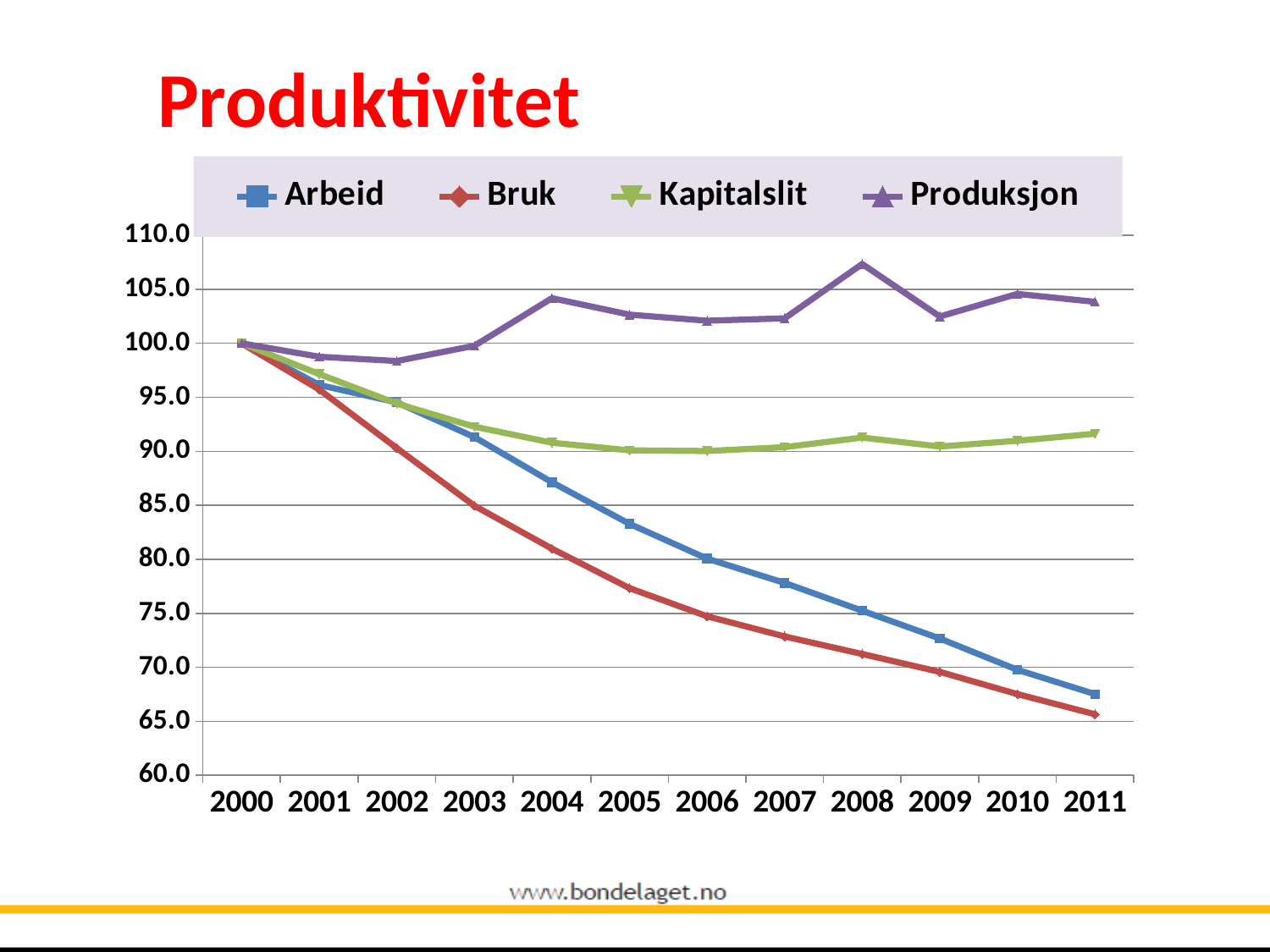
Which series has the highest value in 2011? Produksjon What kind of chart is shown on the slide? line chart Which series has the lowest value in 2011? Bruk Is the value for Kapitalslit in 2005 greater or less than 95.0? less Is the value for Bruk in 2011 greater or less than 70.0? less Does the Bruk series rise or fall from 2000 to 2011? fall Is the value for Produksjon in 2008 greater or less than 105.0? greater How many years are shown on the x axis? 12 What is the value of Arbeid in 2000? 100.0 How many series does the legend list? 4 In 2011, which is larger, Arbeid or Bruk? Arbeid